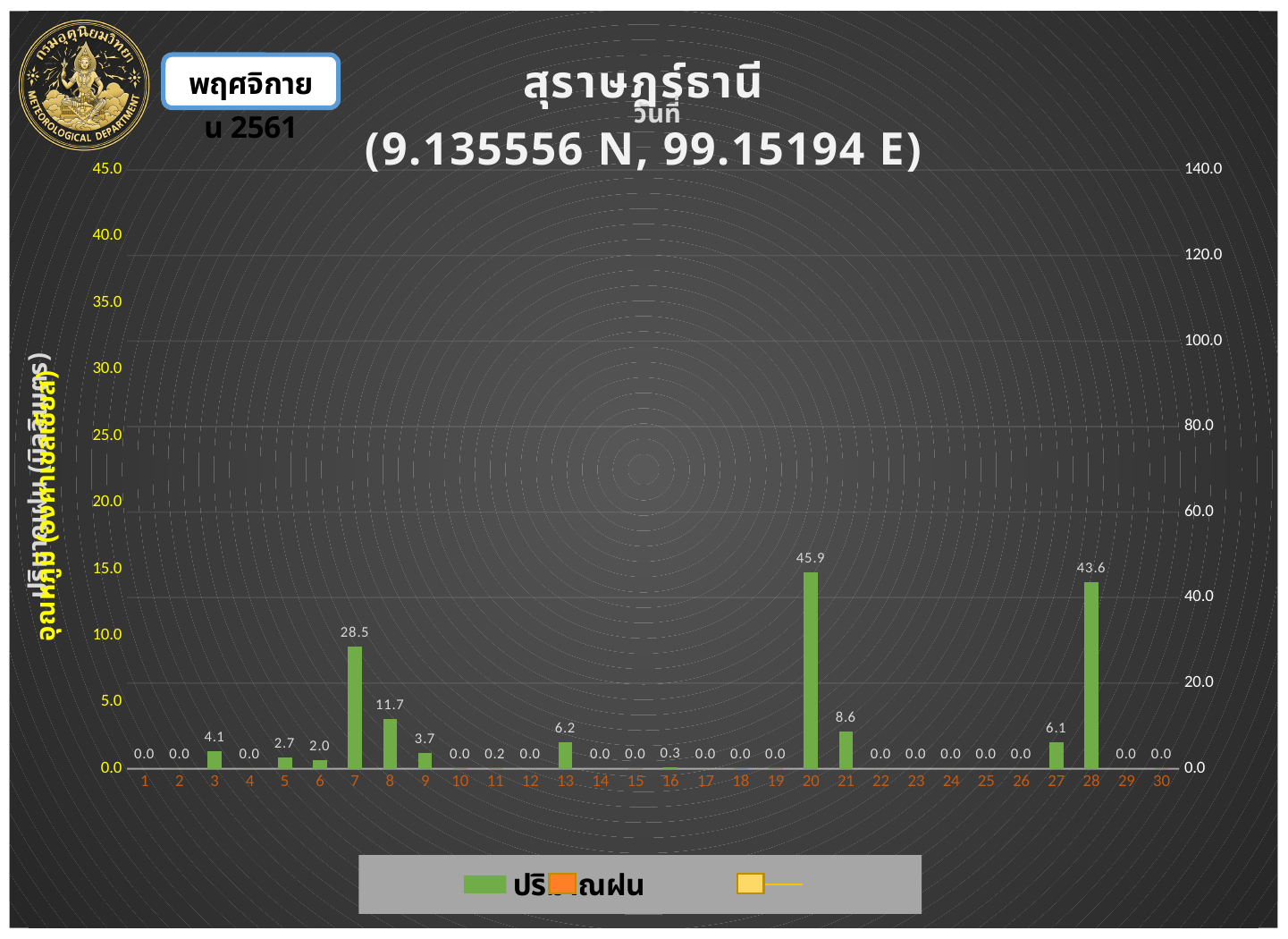
What is the difference between the rainfall values for day 20 and day 28? 2.3 What is the rainfall value shown for day 7? 28.5 Which has the larger rainfall value, day 13 or day 27? day 13 What kind of chart is shown on the slide? bar chart What is the rainfall value shown for day 21? 8.6 What is the rainfall value shown for day 28? 43.6 What coordinates are given in the chart title? 9.135556 N, 99.15194 E What is the difference between the rainfall values for day 7 and day 8? 16.8 What is the rainfall value shown for day 20? 45.9 How many days are shown on the x axis of the chart? 30 Which has the larger rainfall value, day 7 or day 8? day 7 Which day has the highest rainfall value? 20